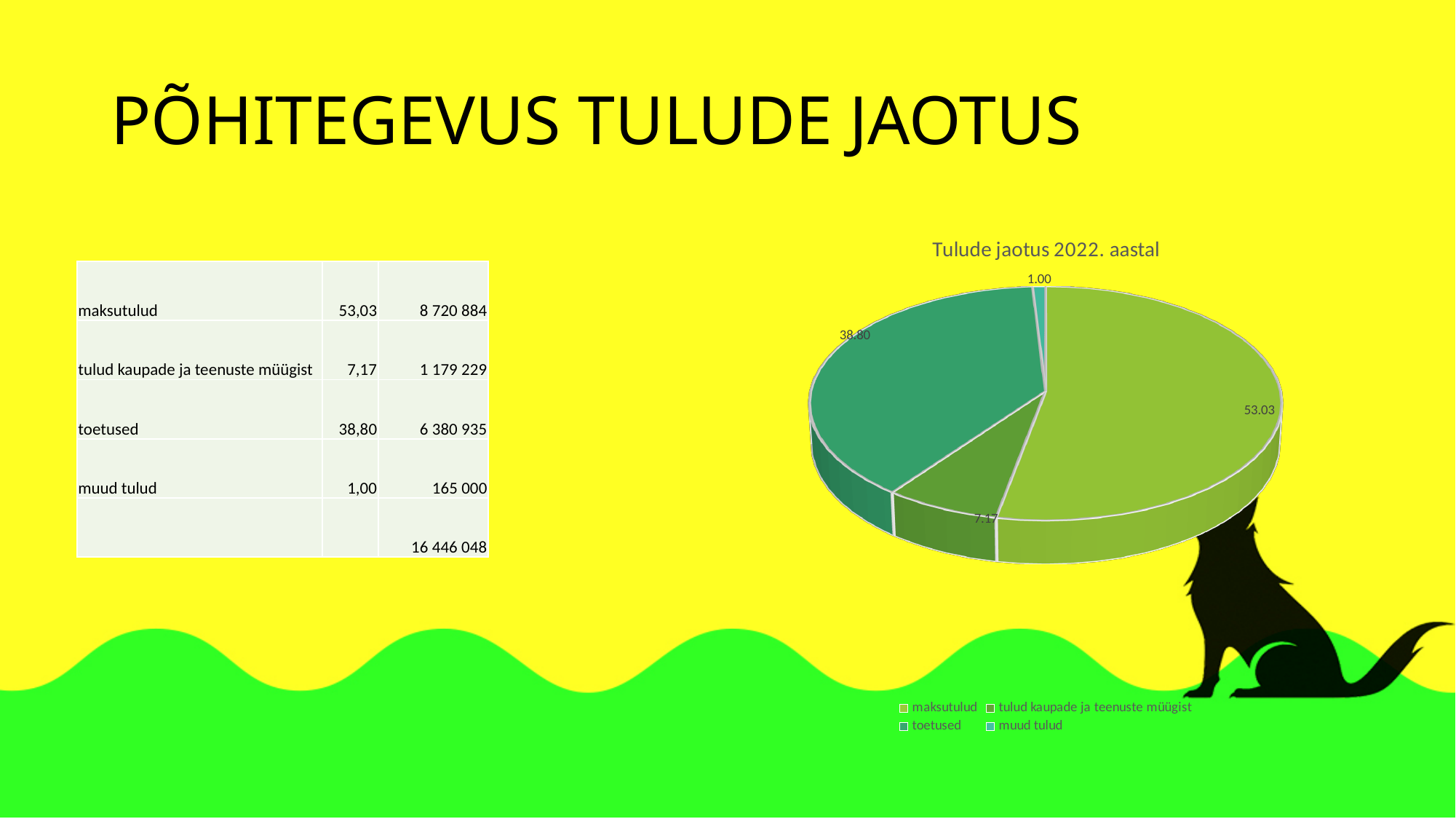
What is the difference between the maksutulud value and the toetused value? 14.23 What value is shown for the toetused slice? 38.80 How many entries does the legend list? 4 Which category has the largest slice of the pie? maksutulud How many slices does the pie chart have? 4 What type of chart is shown on the slide? pie chart Which is larger, the toetused slice or the tulud kaupade ja teenuste müügist slice? toetused What is the title of the chart? Tulude jaotus 2022. aastal What value is shown for the tulud kaupade ja teenuste müügist slice? 7.17 Which category has the smallest slice of the pie? muud tulud What value is shown for the maksutulud slice? 53.03 What value is shown for the muud tulud slice? 1.00